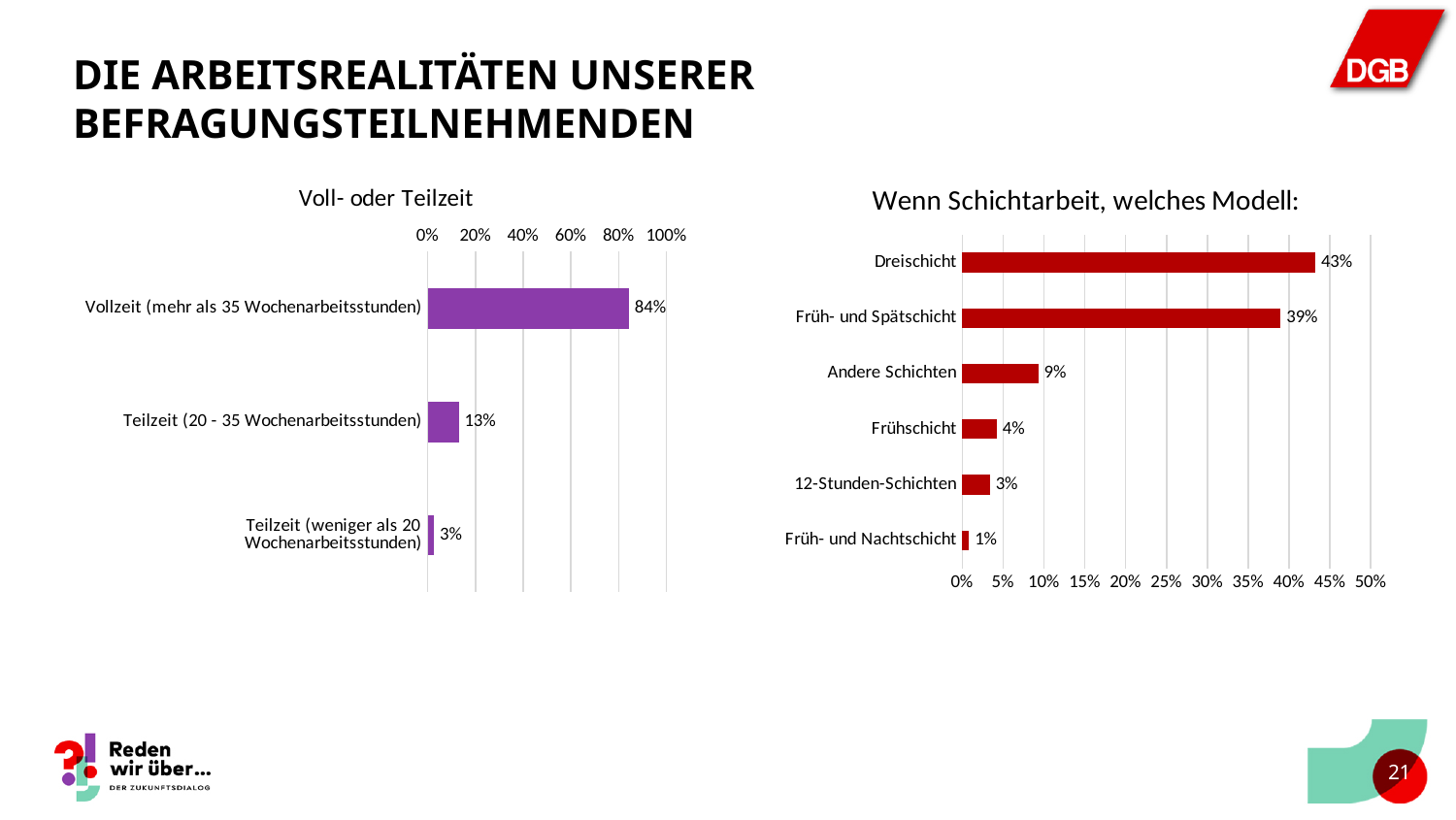
In the 'Voll- oder Teilzeit' chart, what is the difference between Vollzeit and Teilzeit (20 - 35 Wochenarbeitsstunden)? 71% In the 'Voll- oder Teilzeit' chart, what is the value for Vollzeit (mehr als 35 Wochenarbeitsstunden)? 84% In the 'Voll- oder Teilzeit' chart, what is the value for Teilzeit (20 - 35 Wochenarbeitsstunden)? 13% In the 'Wenn Schichtarbeit, welches Modell:' chart, which category has the lowest value? Früh- und Nachtschicht In the 'Wenn Schichtarbeit, welches Modell:' chart, how many categories are shown? 6 In the 'Wenn Schichtarbeit, welches Modell:' chart, what is the value for Früh- und Spätschicht? 39% In the 'Wenn Schichtarbeit, welches Modell:' chart, which category has the highest value? Dreischicht In the 'Voll- oder Teilzeit' chart, which category has the lowest value? Teilzeit (weniger als 20 Wochenarbeitsstunden) In the 'Wenn Schichtarbeit, welches Modell:' chart, which is larger: Andere Schichten or Frühschicht? Andere Schichten In the 'Voll- oder Teilzeit' chart, how many categories are shown? 3 What type of chart is the 'Wenn Schichtarbeit, welches Modell:' chart? Bar chart In the 'Wenn Schichtarbeit, welches Modell:' chart, what is the difference between Dreischicht and Früh- und Spätschicht? 4%